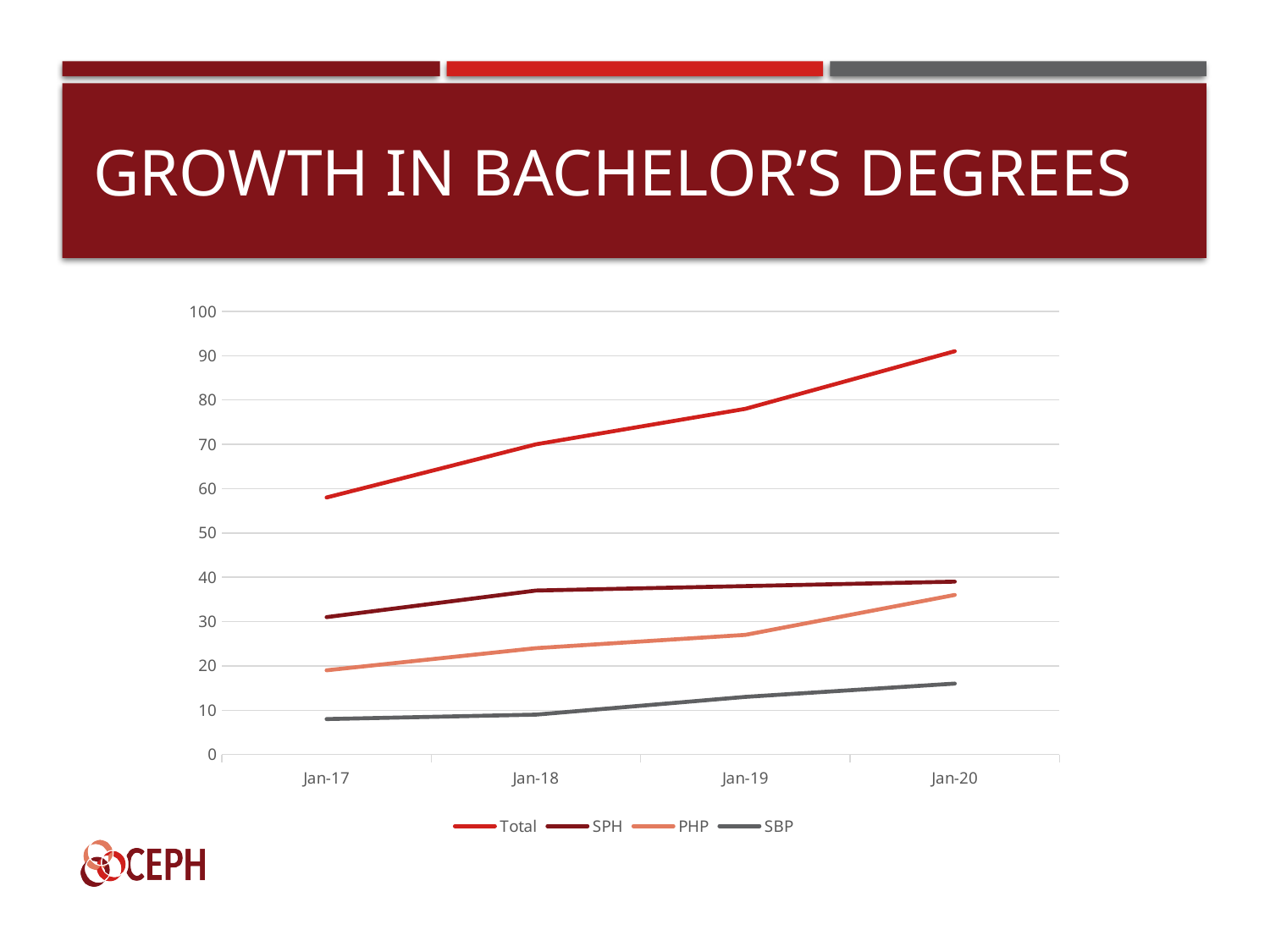
At Jan-17, which is larger, the value for SPH or the value for PHP? SPH Is the value for Total at Jan-18 greater or less than 60? greater Is the value for Total at Jan-20 greater or less than 80? greater Which series has the lowest value at Jan-17? SBP Is the value for SBP at Jan-17 greater or less than 10? less Does the Total series rise or fall from Jan-17 to Jan-20? rise What kind of chart is shown on the slide? line chart What is the title of the slide containing the chart? GROWTH IN BACHELOR'S DEGREES How many series does the legend list? 4 Which series has the highest value at Jan-20? Total How many time points are plotted along the x axis? 4